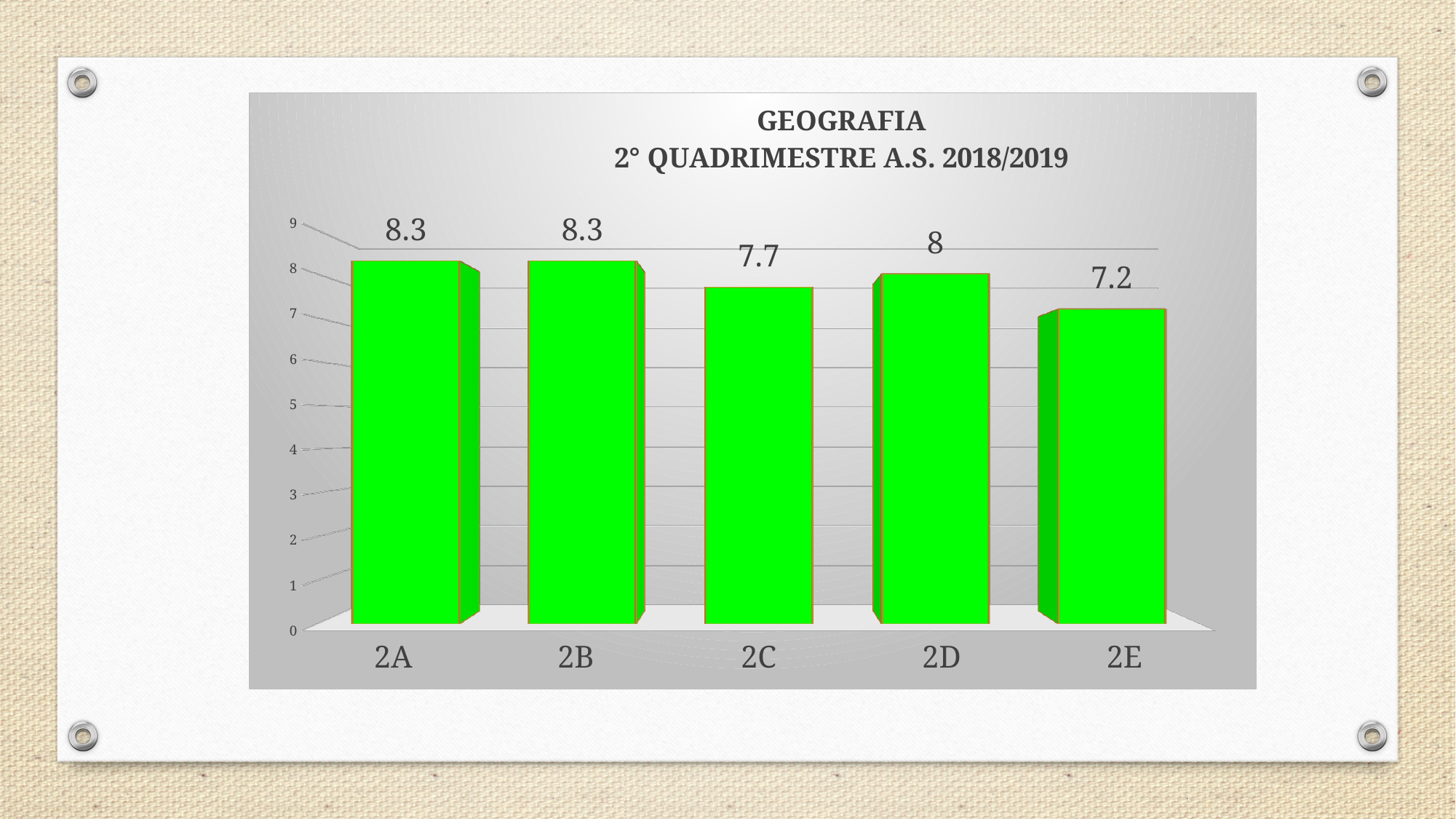
How many categories are shown on the x axis? 5 What is the value for 2D? 8 Is the value for 2C greater or less than 8? less Which is larger, the value for 2B or the value for 2D? 2B What kind of chart is shown on the slide? bar chart What is the difference between the values for 2D and 2C? 0.3 What is the value for 2E? 7.2 What is the value for 2A? 8.3 Which category has the lowest value? 2E What is the difference between the values for 2A and 2E? 1.1 What is the value for 2C? 7.7 What is the title of the chart? GEOGRAFIA 2° QUADRIMESTRE A.S. 2018/2019